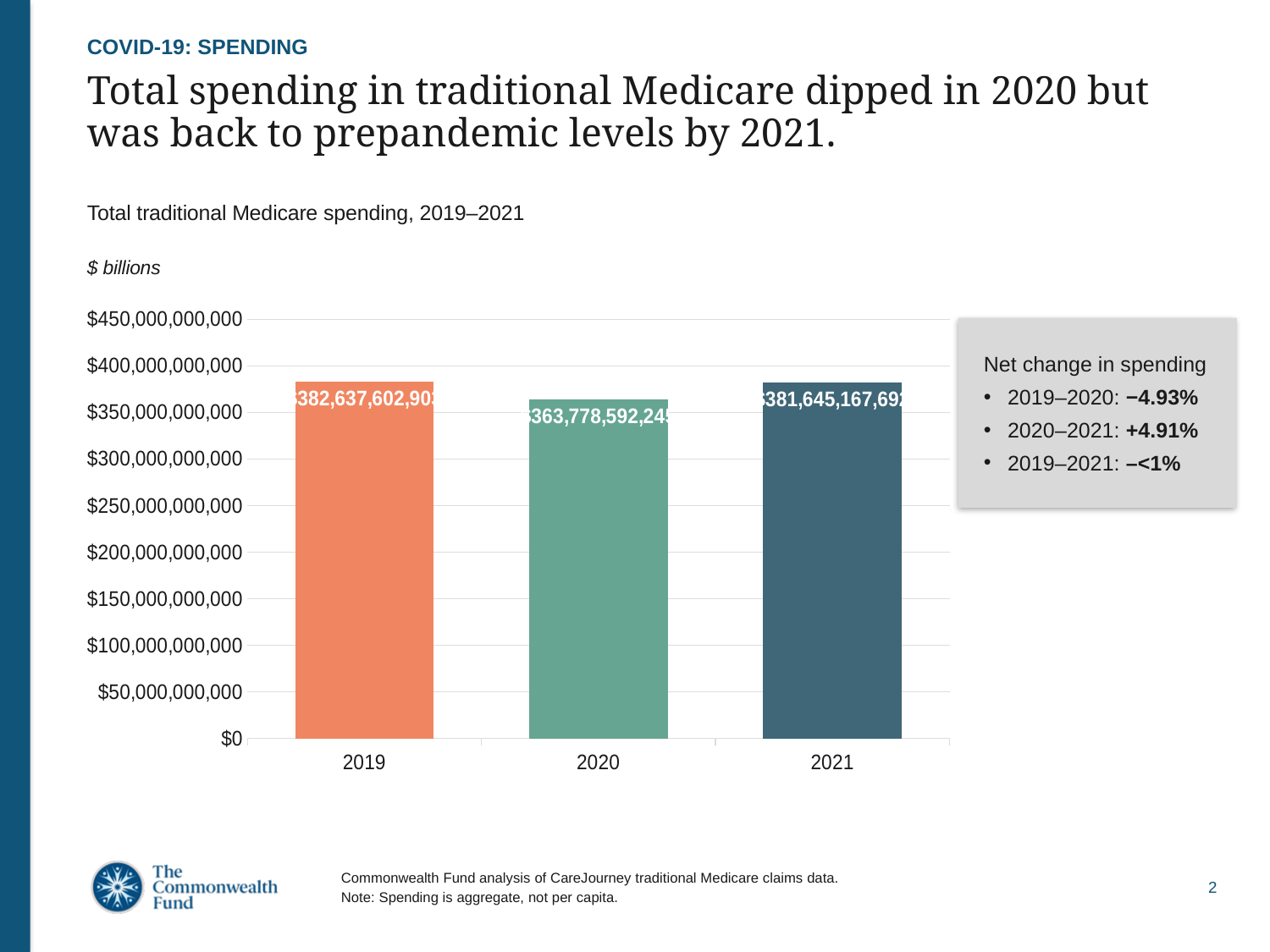
Is the value for 2020 greater or less than $400,000,000,000? less What is the highest value shown on the y axis? $450,000,000,000 What is the title of the chart? Total traditional Medicare spending, 2019–2021 Which is larger, the spending in 2019 or in 2020? 2019 How does total spending change from 2019 to 2021 along the x axis? falls in 2020, then rises in 2021 How many years are plotted in the chart? 3 Is the value for 2019 greater or less than $400,000,000,000? less Which year has the lowest total traditional Medicare spending? 2020 Is the value for 2021 greater or less than $350,000,000,000? greater What kind of chart is shown on the slide? bar chart Which is larger, the spending in 2020 or in 2021? 2021